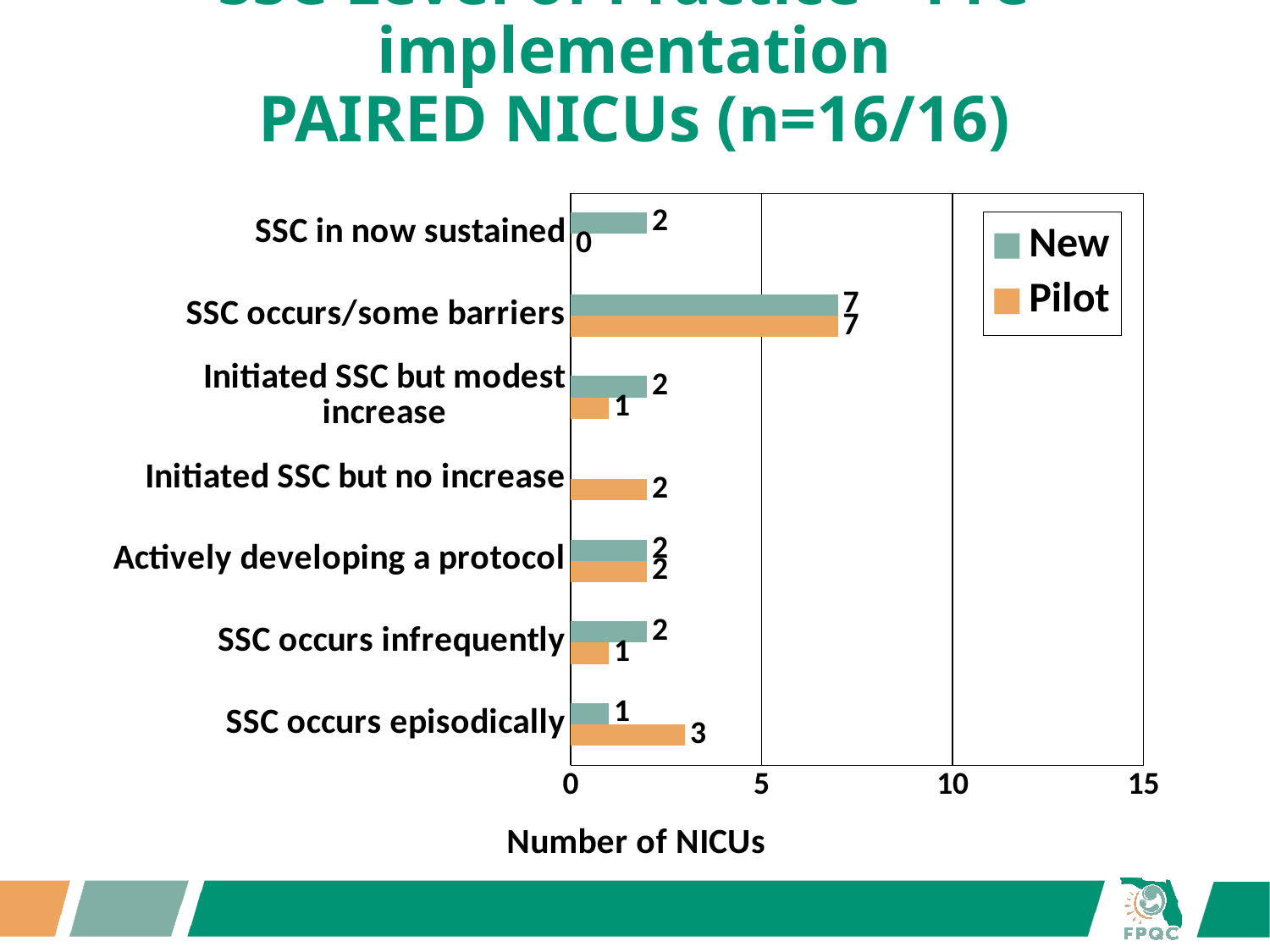
What is the New value for "SSC occurs/some barriers"? 7 How many categories are shown on the vertical axis of the chart? 7 How many series does the legend list? 2 What is the Pilot value for "SSC in now sustained"? 0 What is the label of the horizontal axis? Number of NICUs Is the New value for "SSC occurs/some barriers" greater or less than 5? greater What is the Pilot value for "SSC occurs episodically"? 3 What kind of chart is shown on the slide? bar chart What is the New value for "SSC occurs infrequently"? 2 What is the difference between the Pilot and New values for "SSC occurs episodically"? 2 Which category has the highest Pilot value? SSC occurs/some barriers For "Initiated SSC but modest increase", which is larger, the New value or the Pilot value? New